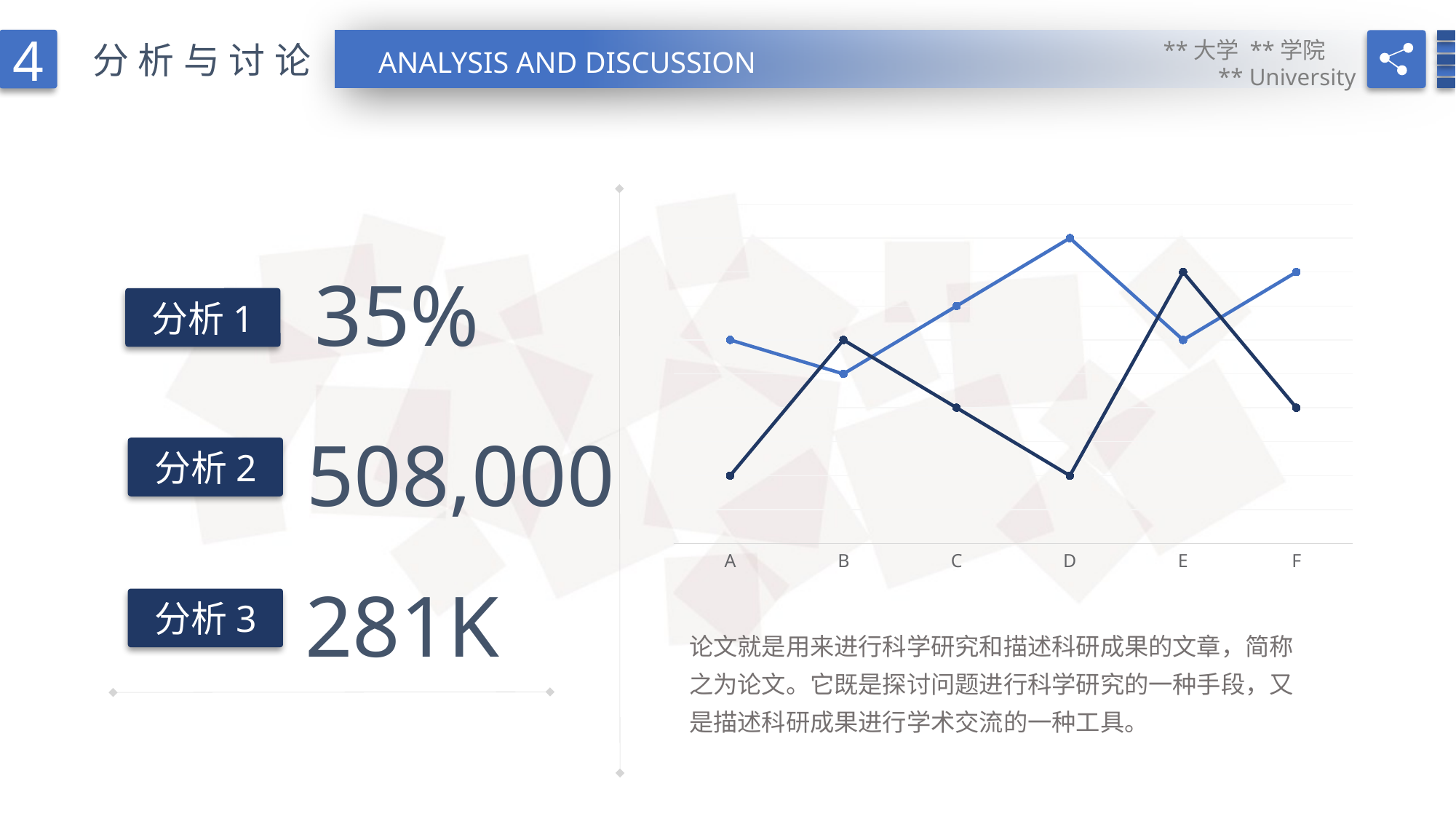
In the line chart, at which category does the light blue line reach its highest point? D How many categories are shown on the x axis of the line chart? 6 In the line chart, at which category does the dark blue line reach its highest point? E What kind of chart is shown on the right side of the slide? line chart In the line chart, does the light blue line rise or fall from category C to category D? rise In the line chart, for the dark blue line, which category has the higher value: B or C? B In the line chart, at category D, which line is higher: the light blue line or the dark blue line? light blue line How many lines (series) are plotted in the line chart? 2 What are the labels of the first and last categories on the x axis of the line chart? A and F In the line chart, does the dark blue line rise or fall from category B to category D? fall In the line chart, at which category does the light blue line reach its lowest point? B In the line chart, at category E, which line is higher: the light blue line or the dark blue line? dark blue line